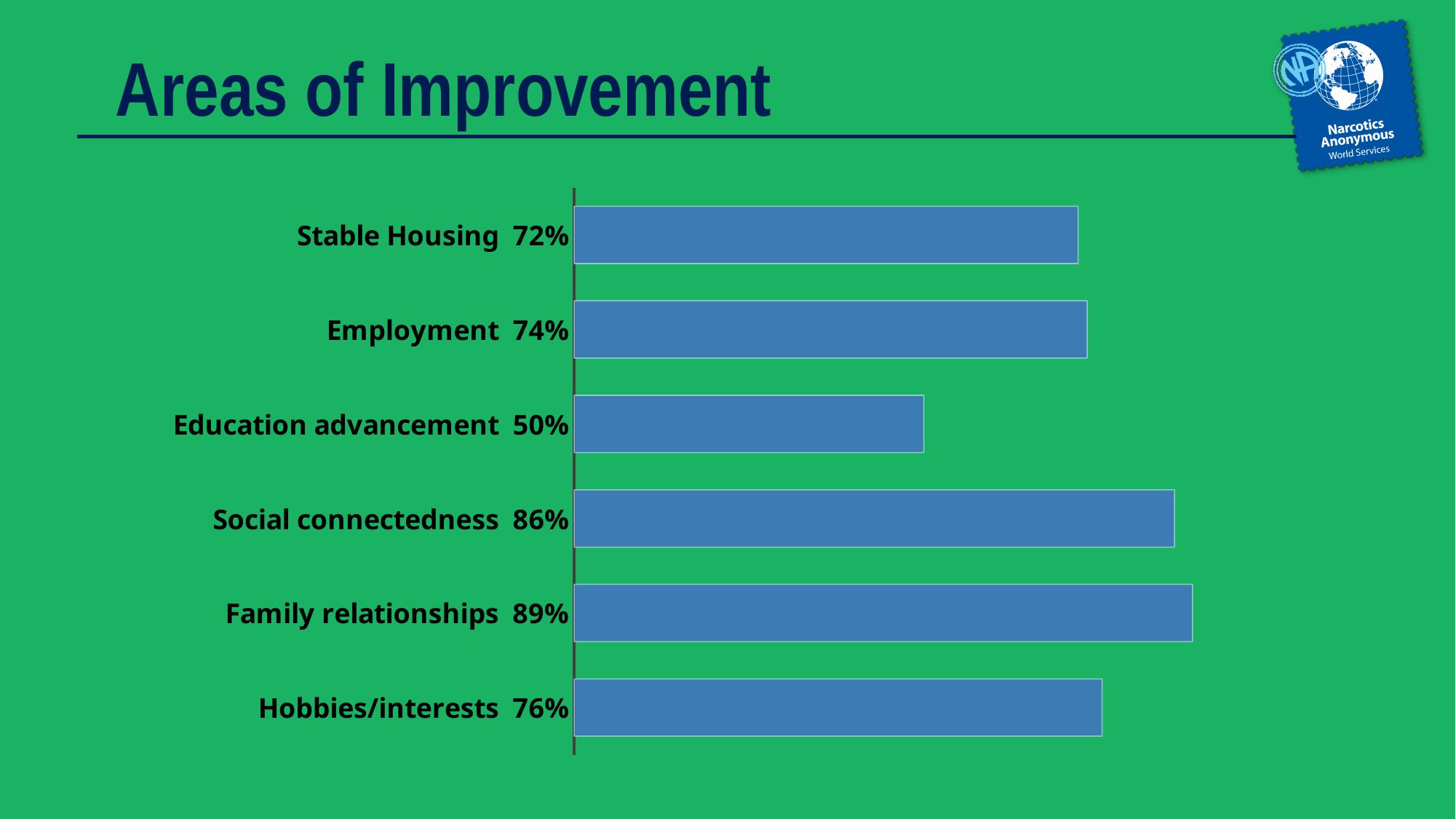
What is the title of the slide containing the chart? Areas of Improvement Which is larger, the value for Social connectedness or the value for Hobbies/interests? Social connectedness How many categories are shown in the chart? 6 What is the value for Stable Housing? 72% Which category has the lowest value? Education advancement What is the value for Hobbies/interests? 76% What is the value for Education advancement? 50% What colour are the bars in the chart? Blue What is the difference between the values for Family relationships and Education advancement? 39% What kind of chart is shown on the slide? Bar chart What is the difference between the values for Employment and Stable Housing? 2% Which category has the highest value? Family relationships